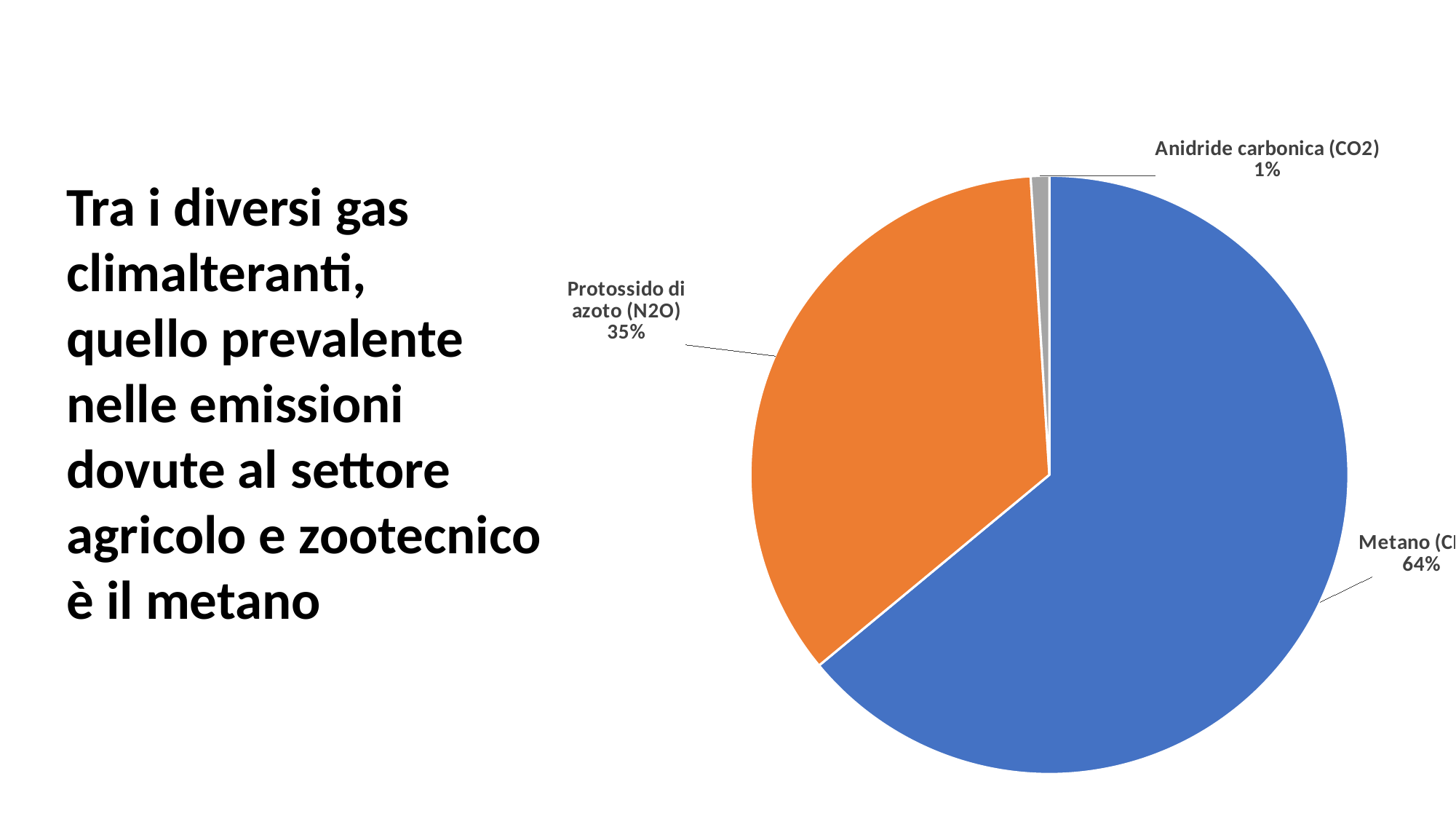
What colour is the Protossido di azoto (N2O) slice? Orange What share of the pie does Anidride carbonica (CO2) have? 1% What share of the pie does Metano have? 64% What colour is the Metano slice? Blue Which gas has the smallest slice of the pie? Anidride carbonica (CO2) Which gas has the largest slice of the pie? Metano Which is larger, the Protossido di azoto (N2O) slice or the Anidride carbonica (CO2) slice? Protossido di azoto (N2O) What kind of chart is shown on the slide? Pie chart What is the difference in percentage points between the Protossido di azoto (N2O) slice and the Anidride carbonica (CO2) slice? 34 What is the difference in percentage points between the Metano slice and the Protossido di azoto (N2O) slice? 29 How many slices does the pie chart have? 3 What share of the pie does Protossido di azoto (N2O) have? 35%